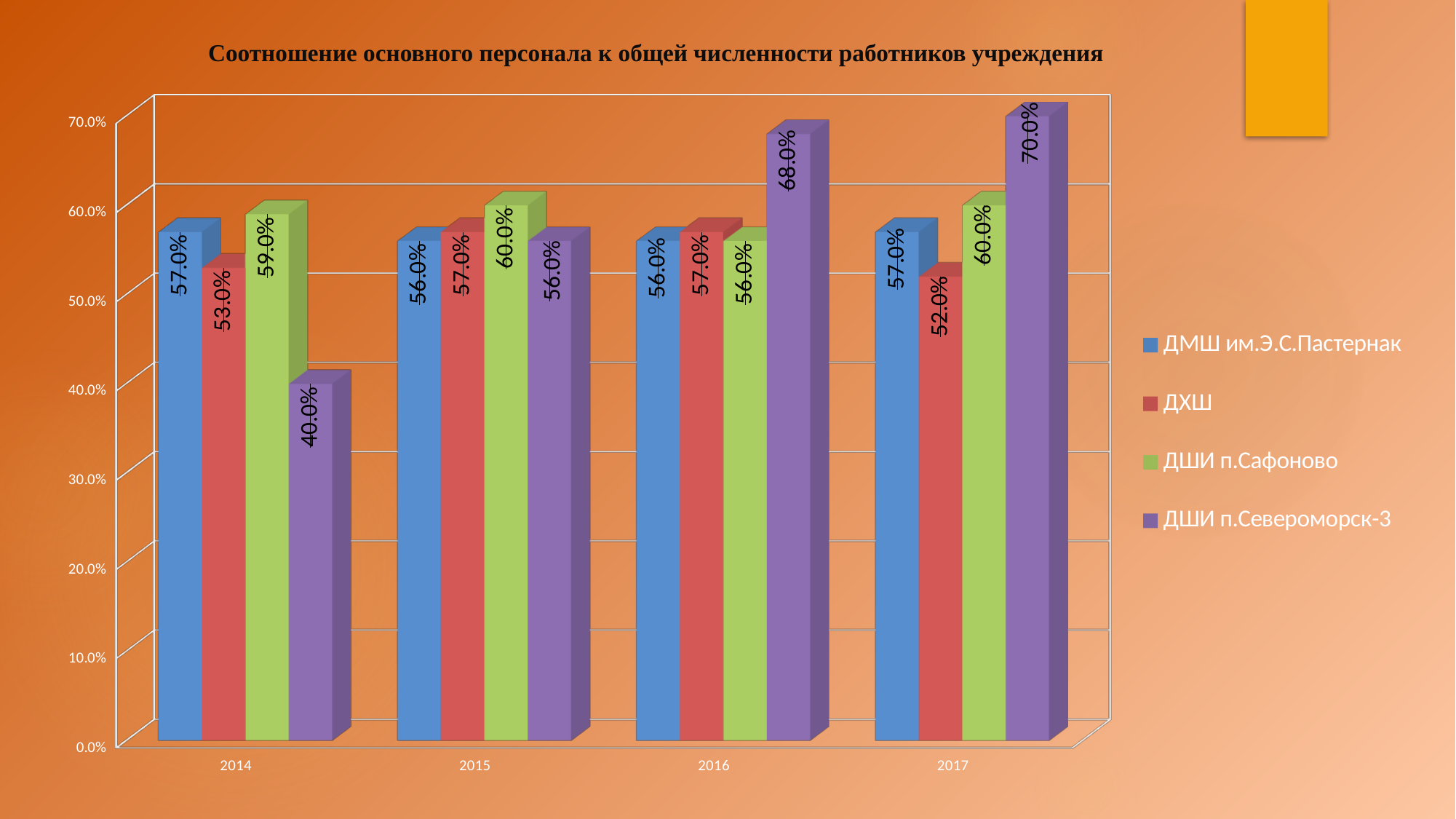
In which year does ДШИ п.Североморск-3 have its highest value? 2017 What kind of chart is shown on the slide? bar chart How many series does the legend list? 4 How many years are shown on the x axis? 4 What is the value for ДШИ п.Сафоново in 2015? 60.0% Which is larger in 2016: the value for ДХШ or the value for ДШИ п.Североморск-3? ДШИ п.Североморск-3 What is the value for ДХШ in 2017? 52.0% Which series has the lowest value in 2014? ДШИ п.Североморск-3 What is the value for ДШИ п.Североморск-3 in 2014? 40.0% What is the difference between the ДШИ п.Североморск-3 values in 2017 and 2014? 30.0% Do the values for ДШИ п.Североморск-3 rise or fall from 2014 to 2017? rise What is the value for ДМШ им.Э.С.Пастернак in 2016? 56.0%